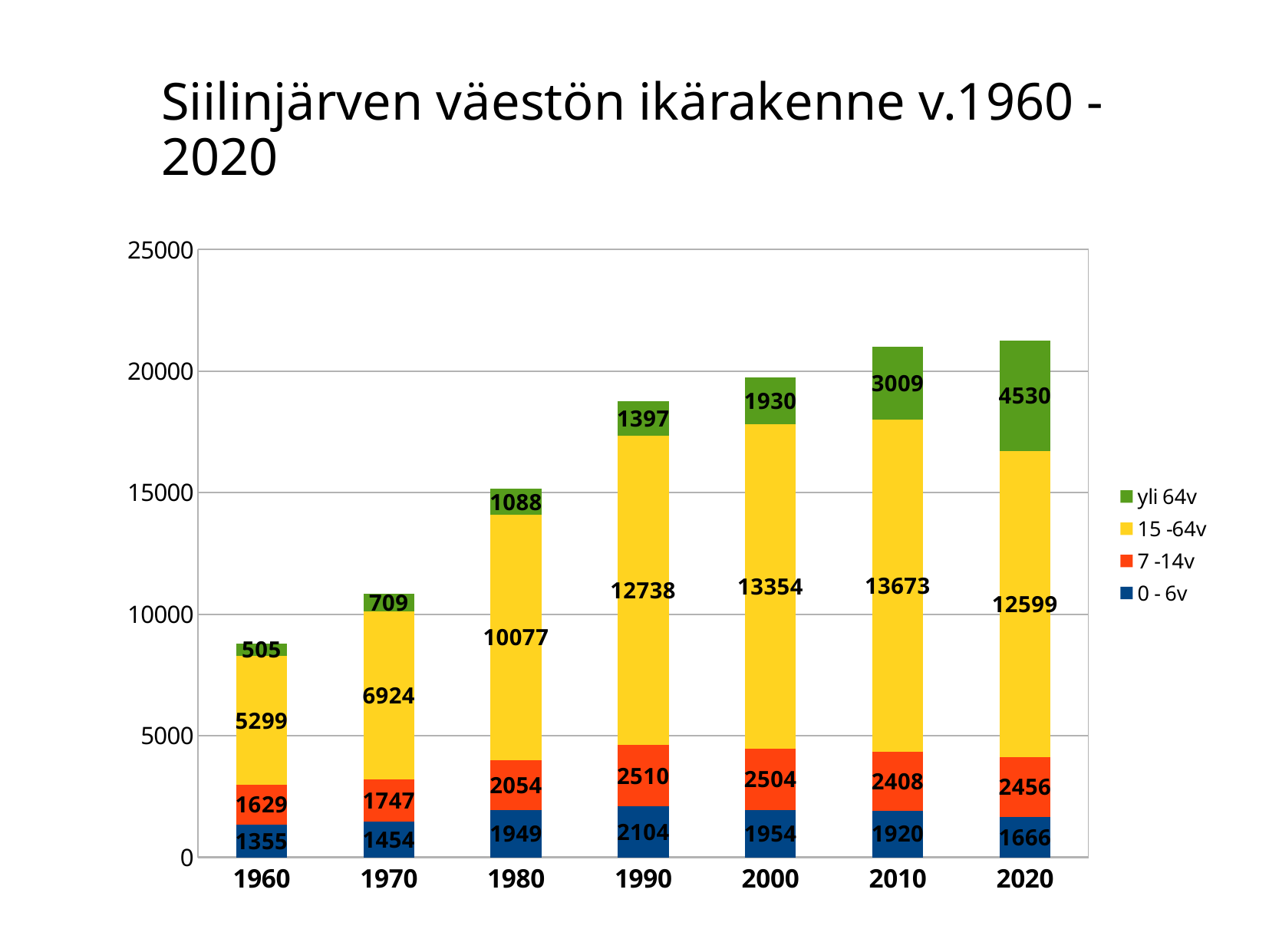
What is the value for the yli 64v series in 2020? 4530 In which year is the 15 -64v value lowest? 1960 How many series does the legend list? 4 What kind of chart is shown on the slide? stacked bar chart How many years are shown on the x axis? 7 What is the value for the 0 - 6v series in 1960? 1355 What is the value for the 15 -64v series in 1990? 12738 Is the total height of the 1980 bar greater or less than 15000? greater In which year is the yli 64v value highest? 2020 Which is larger, the 7 -14v value in 1990 or in 2000? 1990 What is the difference between the 15 -64v values in 2010 and 2020? 1074 What is the total of the stacked bar for 2010? 21010